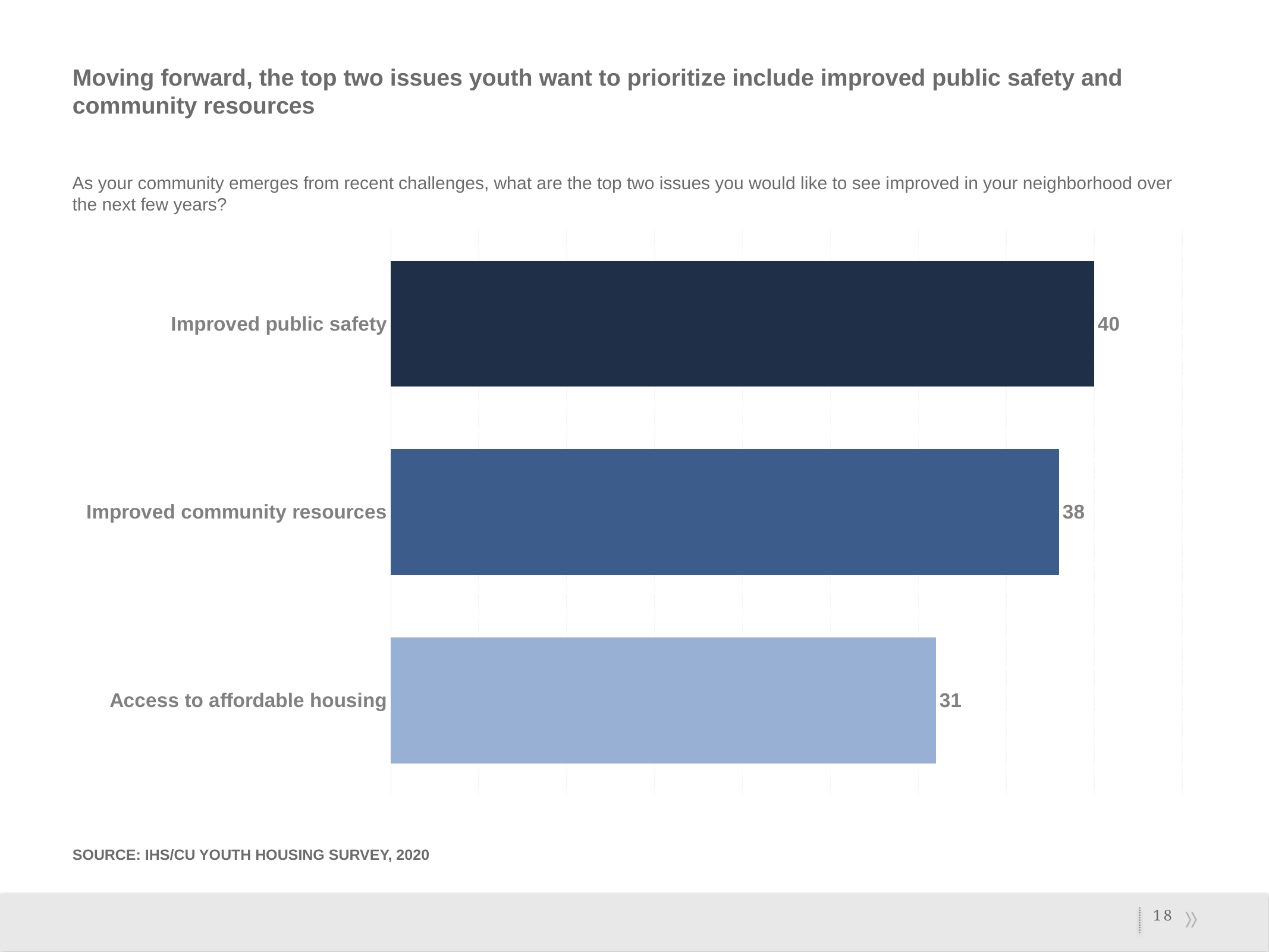
What kind of chart is shown on the slide? Bar chart Which is larger, the value for Improved community resources or the value for Access to affordable housing? Improved community resources Which category has the highest value? Improved public safety Which category has the lowest value? Access to affordable housing What is the difference between the values for Improved community resources and Access to affordable housing? 7 What is the value for Access to affordable housing? 31 What is the difference between the values for Improved public safety and Access to affordable housing? 9 What is the value for Improved community resources? 38 What is the value for Improved public safety? 40 What is the source cited below the chart? IHS/CU YOUTH HOUSING SURVEY, 2020 Which category's bar is the lightest blue? Access to affordable housing How many categories are shown in the chart? 3